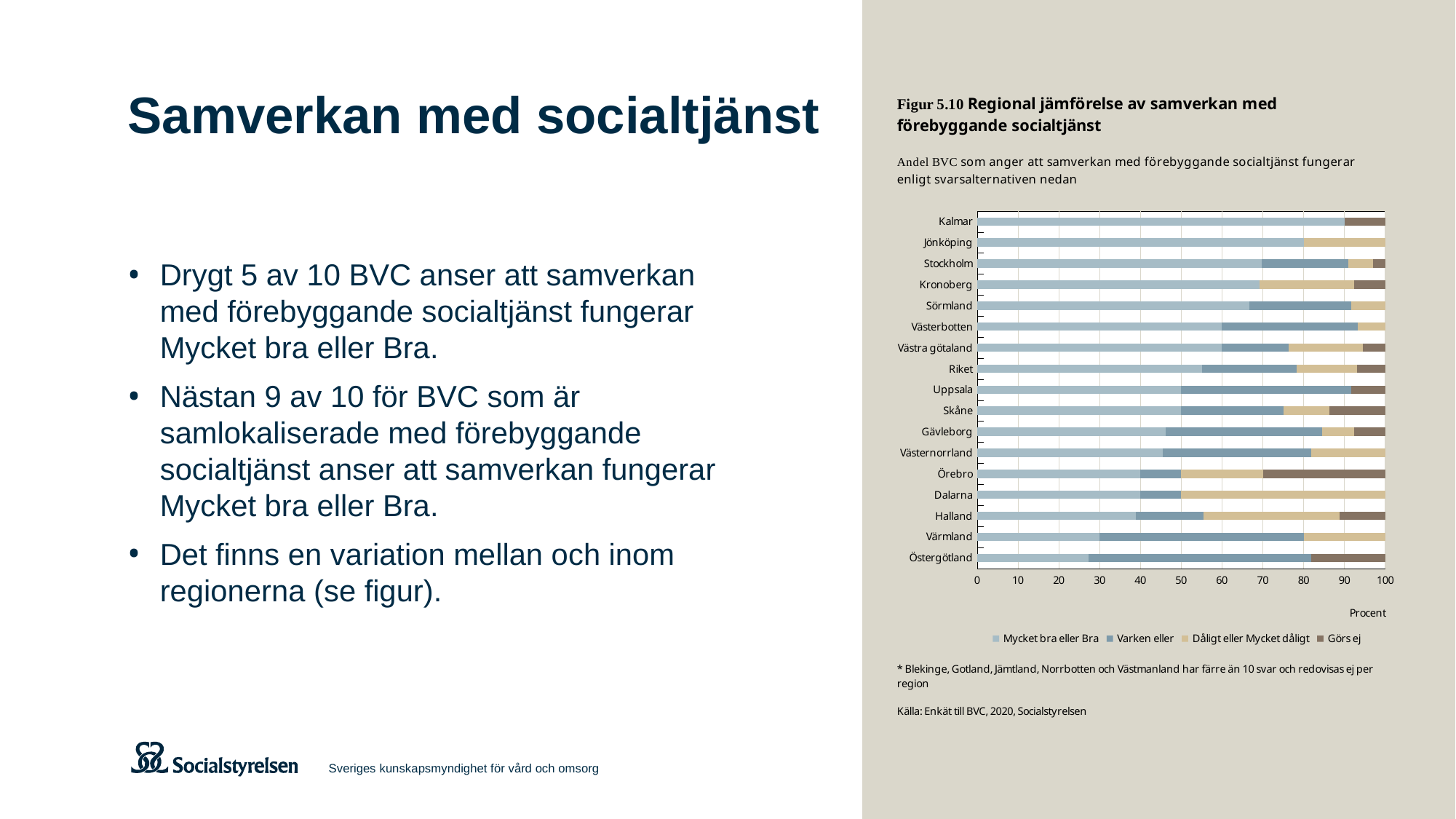
Is the 'Mycket bra eller Bra' value for Östergötland greater or less than 40? less What kind of chart is shown on the slide? bar chart Is the 'Mycket bra eller Bra' value for Örebro greater or less than 50? less Is the 'Mycket bra eller Bra' value for Kronoberg greater or less than 60? greater Which region has the largest 'Mycket bra eller Bra' share? Kalmar Which region has a larger 'Mycket bra eller Bra' share, Kalmar or Östergötland? Kalmar How many series does the chart's legend list? 4 How many regions (categories) are listed on the chart's vertical axis? 17 What unit is shown on the chart's horizontal axis? Procent What is the figure number given in the chart's title? Figur 5.10 Which region has a larger 'Mycket bra eller Bra' share, Jönköping or Dalarna? Jönköping